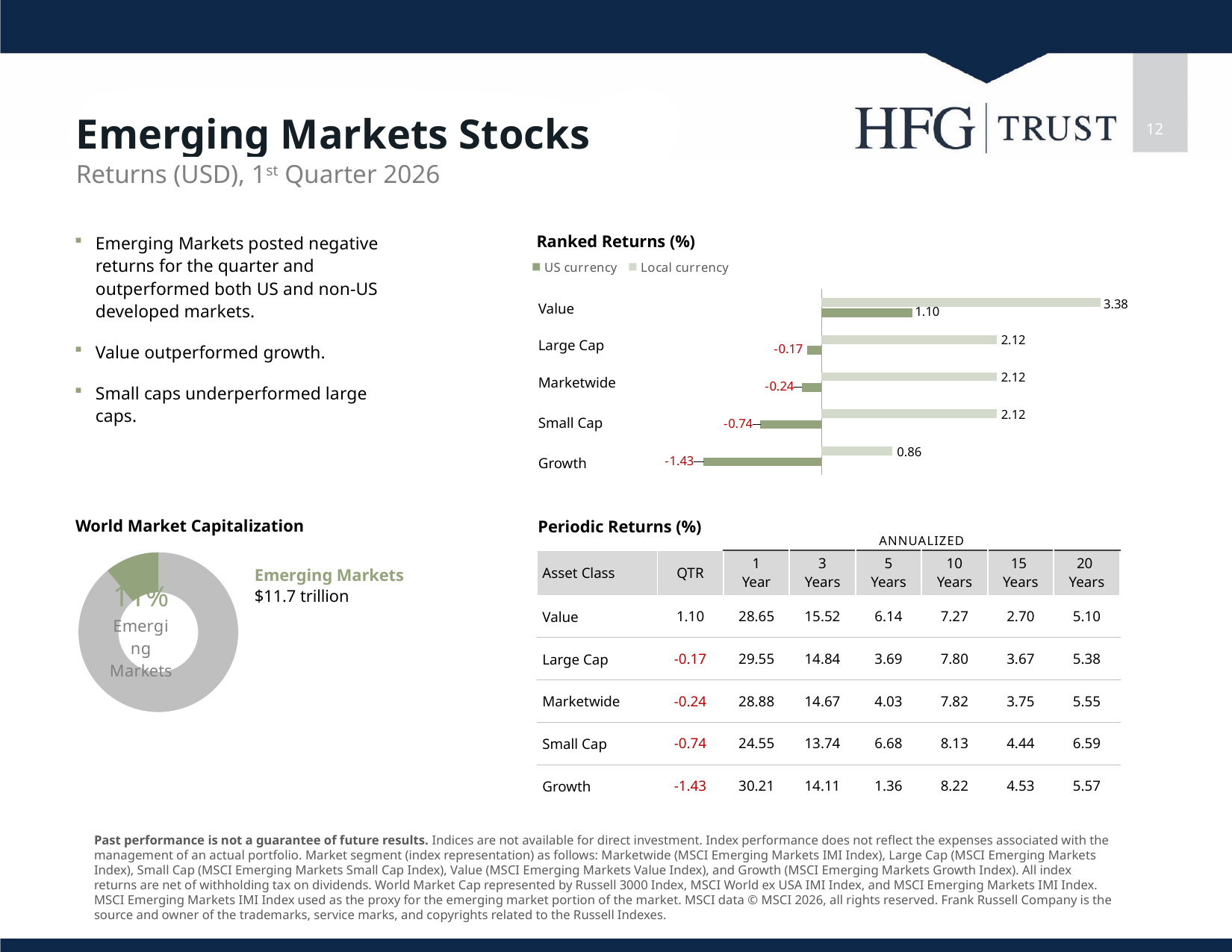
In the Ranked Returns (%) chart, which has the larger US currency return, Small Cap or Growth? Small Cap In the Ranked Returns (%) chart, what is the difference between the Local currency and US currency returns for Growth? 2.29 In the Ranked Returns (%) chart, which category has the highest Local currency return? Value In the Ranked Returns (%) chart, what is the Local currency return for Growth? 0.86 How many categories are shown in the Ranked Returns (%) chart? 5 What kind of chart is the Ranked Returns (%) chart? Bar chart How many series does the legend of the Ranked Returns (%) chart list? 2 In the Ranked Returns (%) chart, what is the Local currency return for Large Cap? 2.12 In the Ranked Returns (%) chart, what is the US currency return for Value? 1.10 In the Ranked Returns (%) chart, what is the difference between the Local currency and US currency returns for Value? 2.28 What are the two legend entries in the Ranked Returns (%) chart? US currency and Local currency In the Ranked Returns (%) chart, which category has the lowest US currency return? Growth